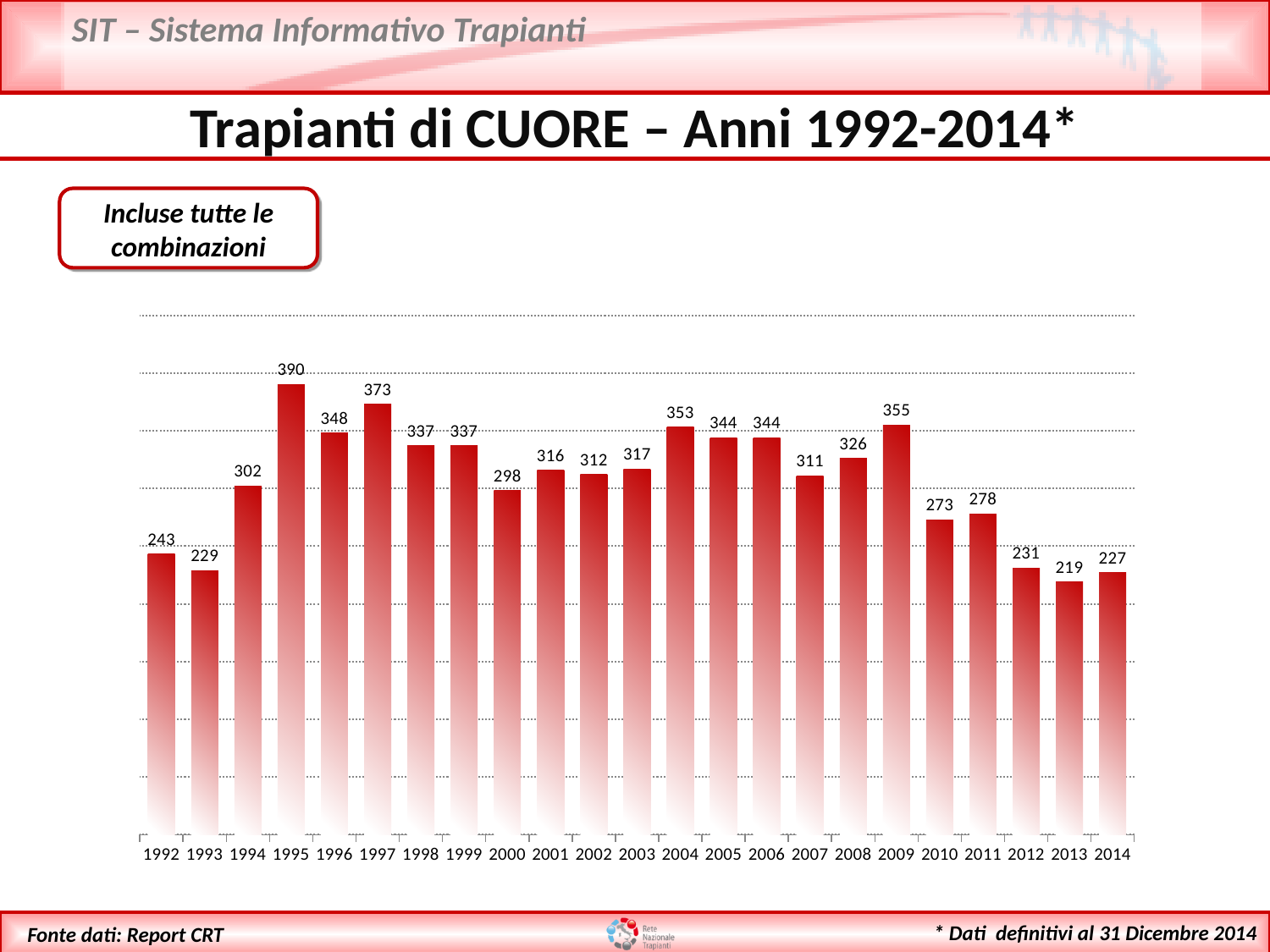
What is the difference between the values for 2009 and 2010? 82 What is the difference between the values for 1995 and 2013? 171 Which year has a larger value, 1997 or 2004? 1997 How many heart transplants were performed in 1995? 390 Which year has the lowest number of heart transplants? 2013 Do the values rise or fall from 2009 to 2013? fall What is the title of the chart on the slide? Trapianti di CUORE – Anni 1992-2014* What is the value shown for 2014? 227 What type of chart is shown on the slide? bar chart What is the value shown for 2009? 355 How many years are shown on the x axis? 23 Which year has the highest number of heart transplants? 1995